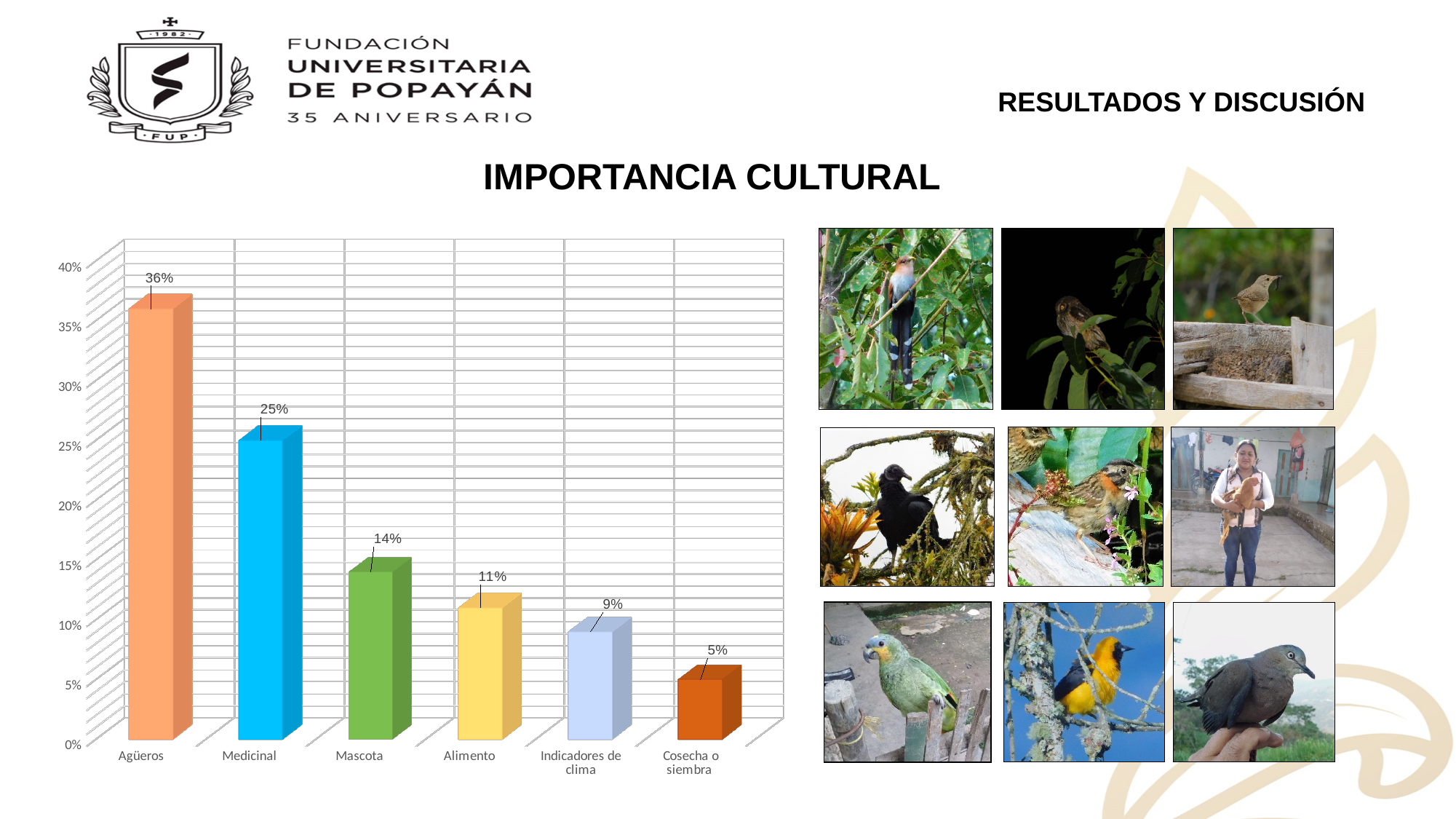
Which category has the highest value? Agüeros Which category has the lowest value? Cosecha o siembra Which is larger, the value for Mascota or the value for Alimento? Mascota What is the difference between the values for Mascota and Alimento? 3% What is the difference between the values for Agüeros and Medicinal? 11% Is the value for Medicinal greater or less than 20%? greater What is the value for Medicinal? 25% How many categories are shown on the x axis? 6 What is the value for Indicadores de clima? 9% Do the values rise or fall from left to right along the x axis? fall What kind of chart is shown on the slide? bar chart What is the value for Agüeros? 36%